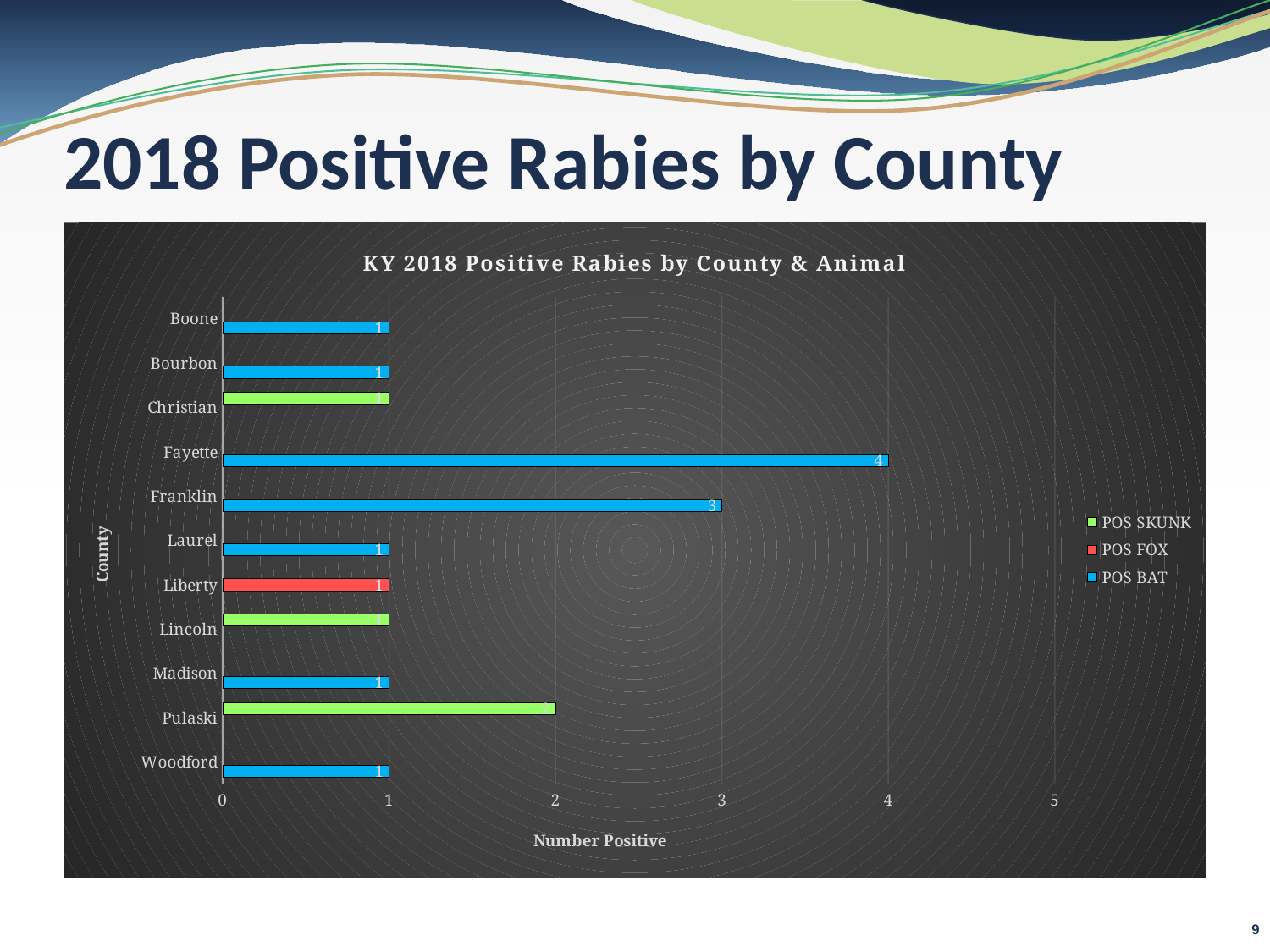
How many series does the legend list? 3 What is the title of the chart? KY 2018 Positive Rabies by County & Animal Which is larger, the POS BAT value for Franklin or the POS SKUNK value for Pulaski? Franklin What is the difference between the POS BAT values for Fayette and Franklin? 1 Which county has the highest number positive? Fayette What is the POS FOX value for Liberty? 1 What type of chart is shown on the slide? bar chart Which series is shown in red in the legend? POS FOX How many counties are shown on the y axis of the chart? 11 What is the POS BAT value for Fayette? 4 What is the POS BAT value for Franklin? 3 What is the POS SKUNK value for Pulaski? 2